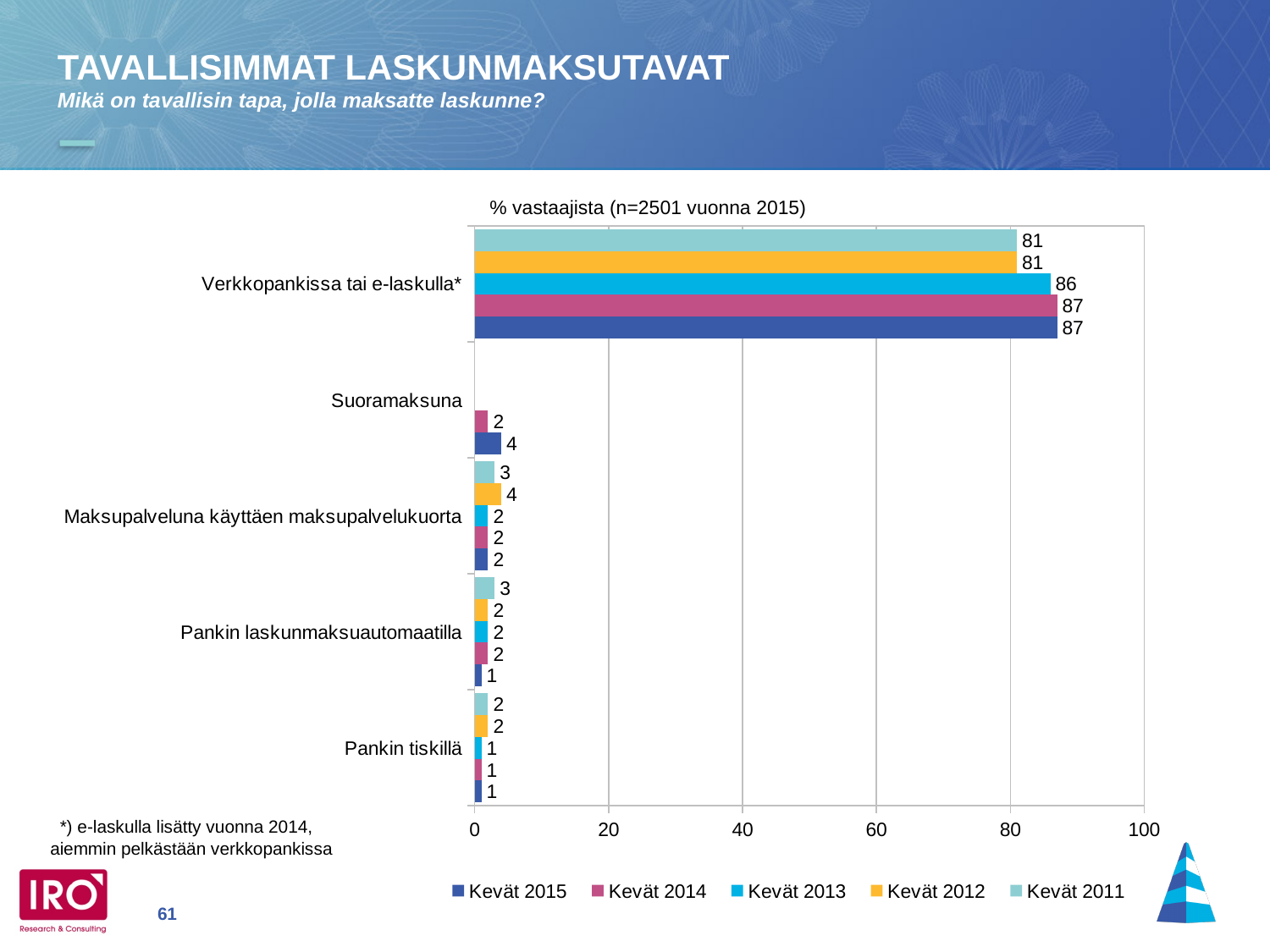
How many series does the legend list? 5 What type of chart is shown on the slide? bar chart What is the value for Suoramaksuna in Kevät 2015? 4 How many payment-method categories are shown on the chart? 5 What is the value for Pankin tiskillä in Kevät 2013? 1 Which category has the highest value in Kevät 2015? Verkkopankissa tai e-laskulla* What is the title printed above the chart? % vastaajista (n=2501 vuonna 2015) What is the value for Verkkopankissa tai e-laskulla* in Kevät 2011? 81 What is the value for Verkkopankissa tai e-laskulla* in Kevät 2015? 87 Is the value for Verkkopankissa tai e-laskulla* in Kevät 2013 greater or less than 80? greater What is the difference between the Kevät 2015 and Kevät 2011 values for Verkkopankissa tai e-laskulla*? 6 What is the value for Maksupalveluna käyttäen maksupalvelukuorta in Kevät 2012? 4